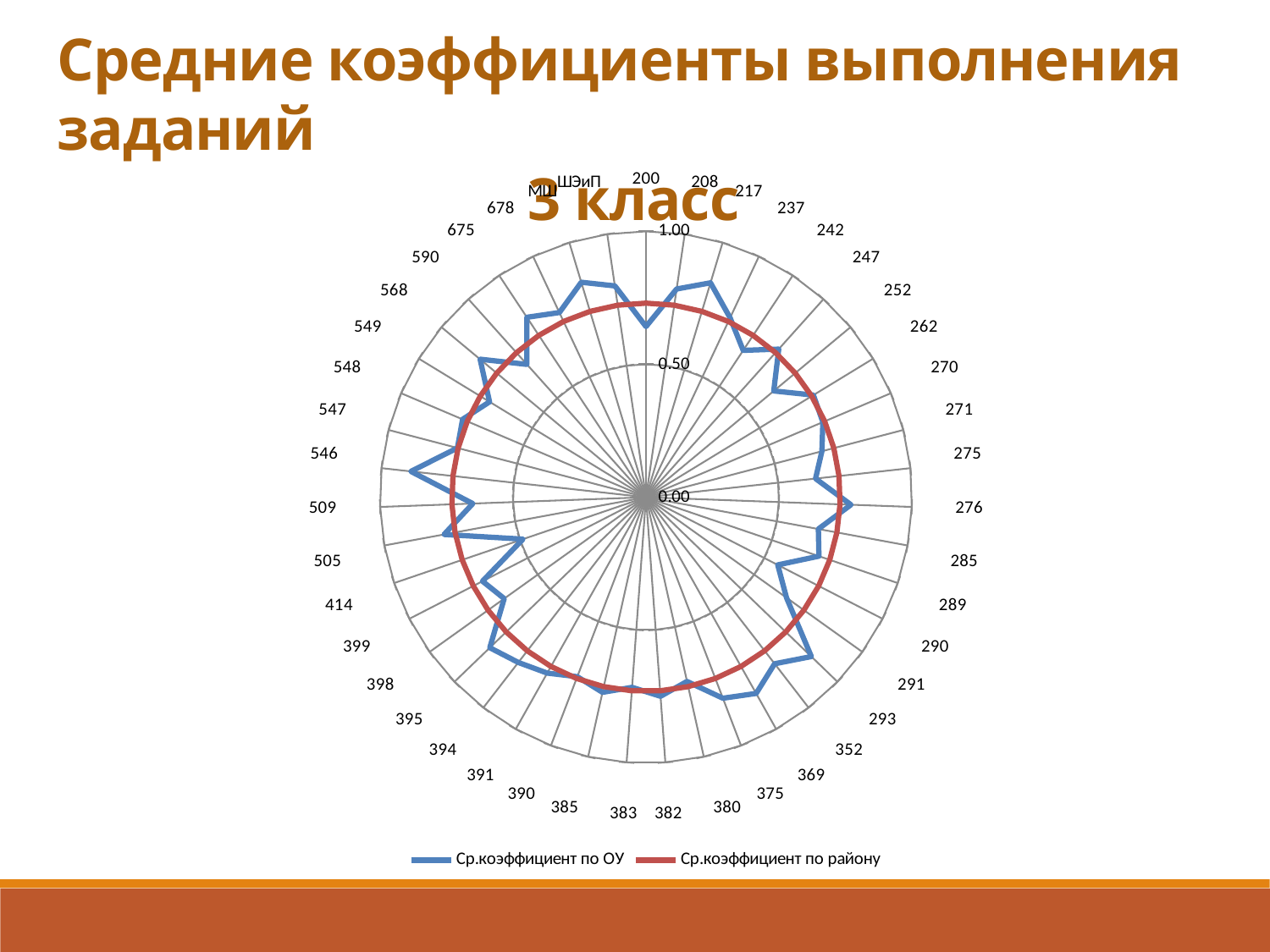
For category 546, which series has the larger value: Ср.коэффициент по ОУ or Ср.коэффициент по району? Ср.коэффициент по ОУ For category 290, which series has the larger value: Ср.коэффициент по ОУ or Ср.коэффициент по району? Ср.коэффициент по району What kind of chart is shown on the slide? radar chart How many categories are plotted around the radar chart? 43 For category 200, which series has the larger value: Ср.коэффициент по ОУ or Ср.коэффициент по району? Ср.коэффициент по району What are the two series named in the legend? Ср.коэффициент по ОУ; Ср.коэффициент по району How many series does the legend list? 2 Is the value of Ср.коэффициент по району for 276 greater or less than 0.50? greater Is the value of Ср.коэффициент по ОУ for 200 greater or less than 1.00? less What is the title of the chart? 3 класс Is the value of Ср.коэффициент по ОУ for 546 greater or less than 0.50? greater